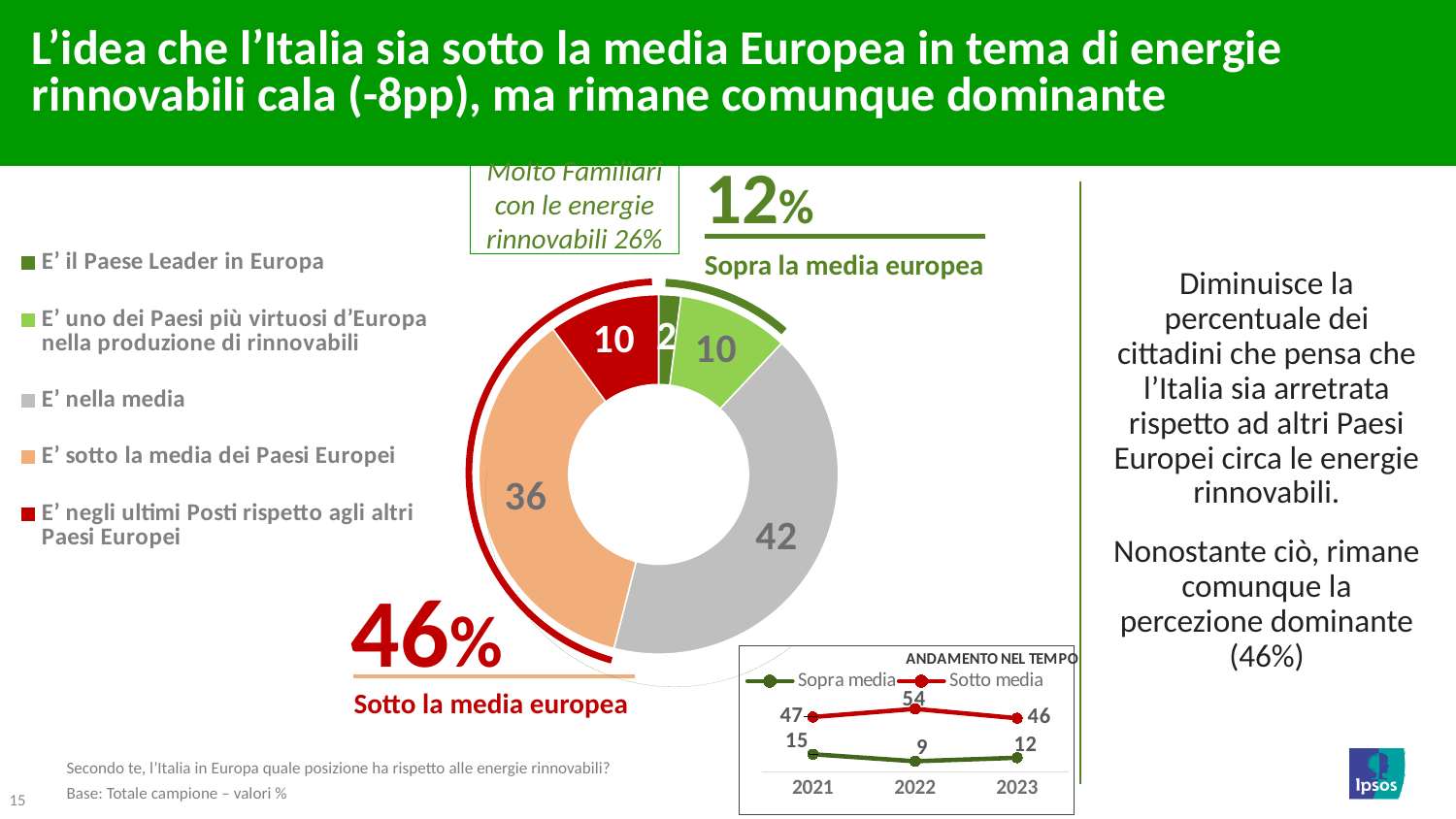
In the 'ANDAMENTO NEL TEMPO' chart, what is the value of 'Sotto media' in 2022? 54 In the donut chart, which category has the smallest share? E' il Paese Leader in Europa In the 'ANDAMENTO NEL TEMPO' chart, what is the value of 'Sopra media' in 2021? 15 In the donut chart, what percentage of respondents say Italy is 'nella media'? 42 In the 'ANDAMENTO NEL TEMPO' chart, how many series does the legend list? 2 In the donut chart, what is the difference between the 'E' nella media' value and the 'E' sotto la media dei Paesi Europei' value? 6 In the donut chart, which category has the largest share? E' nella media In the donut chart, what value is shown for 'E' il Paese Leader in Europa'? 2 In the 'ANDAMENTO NEL TEMPO' chart, what is the difference between 'Sotto media' and 'Sopra media' in 2023? 34 In the donut chart, what value is shown for 'E' sotto la media dei Paesi Europei'? 36 What kind of chart is the 'ANDAMENTO NEL TEMPO' chart? Line chart How many categories does the donut chart's legend list? 5